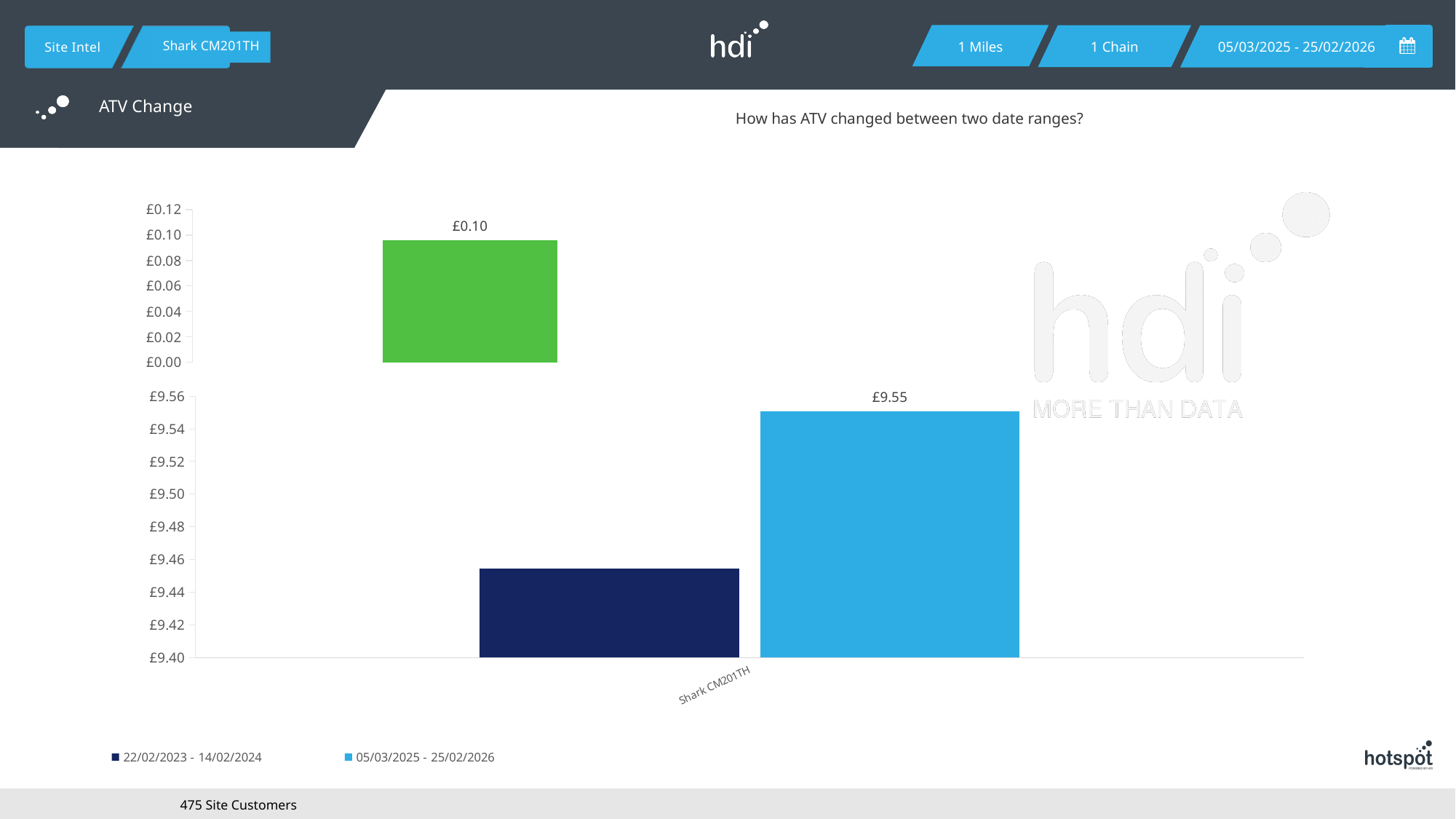
In the bottom chart, what is the ATV value for the 05/03/2025 - 25/02/2026 series? £9.55 In the top chart, what value is printed above the green bar? £0.10 In the bottom chart, is the value for the 22/02/2023 - 14/02/2024 series greater or less than £9.50? less What is the title of the chart section on the slide? ATV Change How many series does the legend at the bottom of the slide list? 2 In the bottom chart, which series has the highest bar? 05/03/2025 - 25/02/2026 In the bottom chart, which series has the lowest bar? 22/02/2023 - 14/02/2024 How many categories are shown on the x axis of the bottom chart? 1 What kind of chart is the bottom chart? bar chart In the bottom chart, which series has the larger value: 22/02/2023 - 14/02/2024 or 05/03/2025 - 25/02/2026? 05/03/2025 - 25/02/2026 What is the category label on the x axis of the bottom chart? Shark CM201TH In the bottom chart, is the value for the 22/02/2023 - 14/02/2024 series greater or less than £9.44? greater